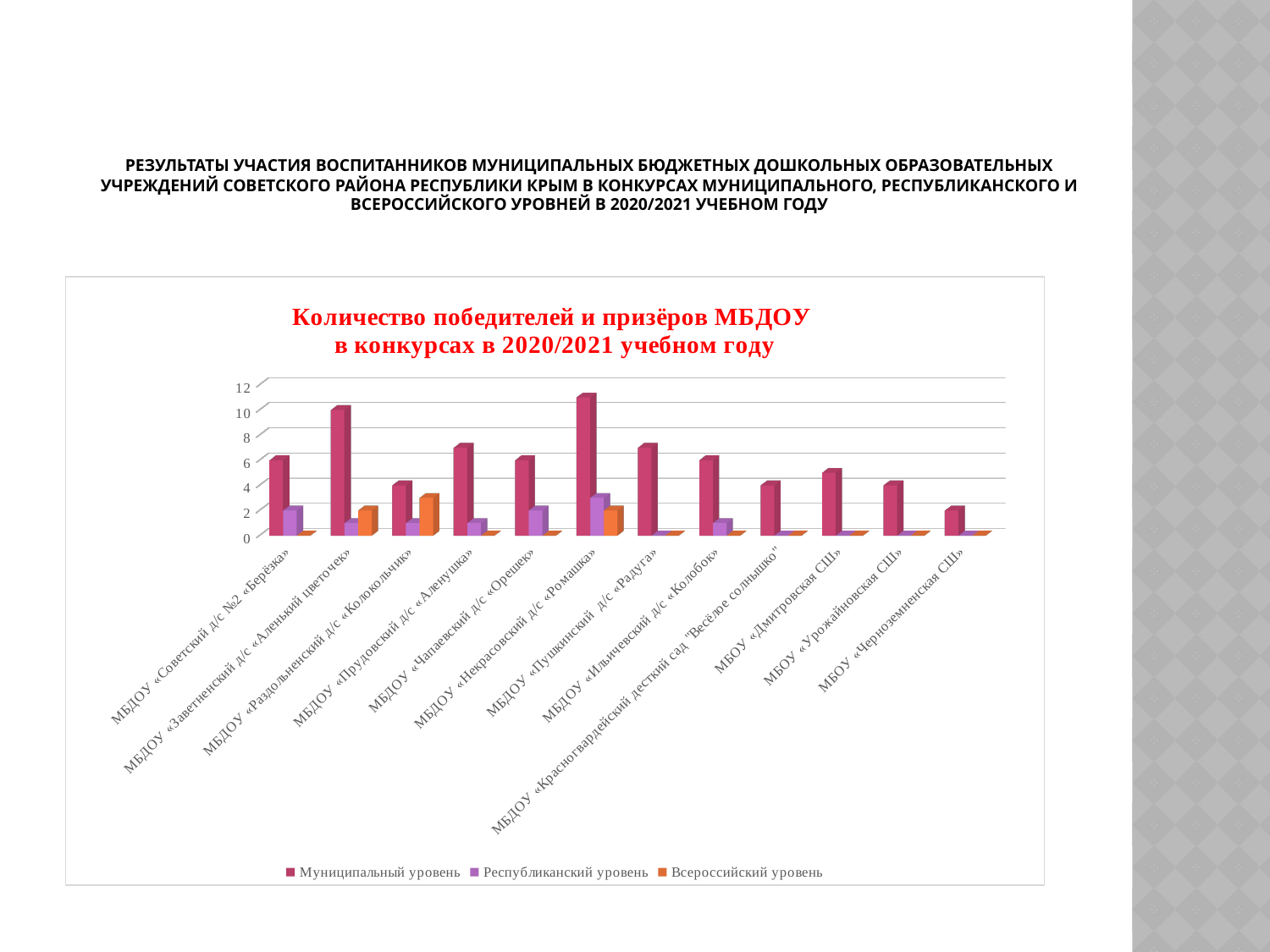
Is the Муниципальный уровень value for МБДОУ «Некрасовский д/с «Ромашка» greater or less than 8? greater Which institution has the lowest value for Муниципальный уровень? МБОУ «Черноземненская СШ» What kind of chart is shown on the slide? Bar chart What is the title of the chart? Количество победителей и призёров МБДОУ в конкурсах в 2020/2021 учебном году Is the Муниципальный уровень value for МБОУ «Черноземненская СШ» greater or less than 4? less Is the Муниципальный уровень value for МБДОУ «Советский д/с №2 «Берёзка» greater or less than 4? greater Which series is shown in orange in the chart legend? Всероссийский уровень How many series does the chart legend list? 3 How many institutions (categories) are shown along the x axis of the chart? 12 Which has the larger Муниципальный уровень value: МБДОУ «Заветненский д/с «Аленький цветочек» or МБДОУ «Раздольненский д/с «Колокольчик»? МБДОУ «Заветненский д/с «Аленький цветочек» Which institution has the highest value for Муниципальный уровень? МБДОУ «Некрасовский д/с «Ромашка»